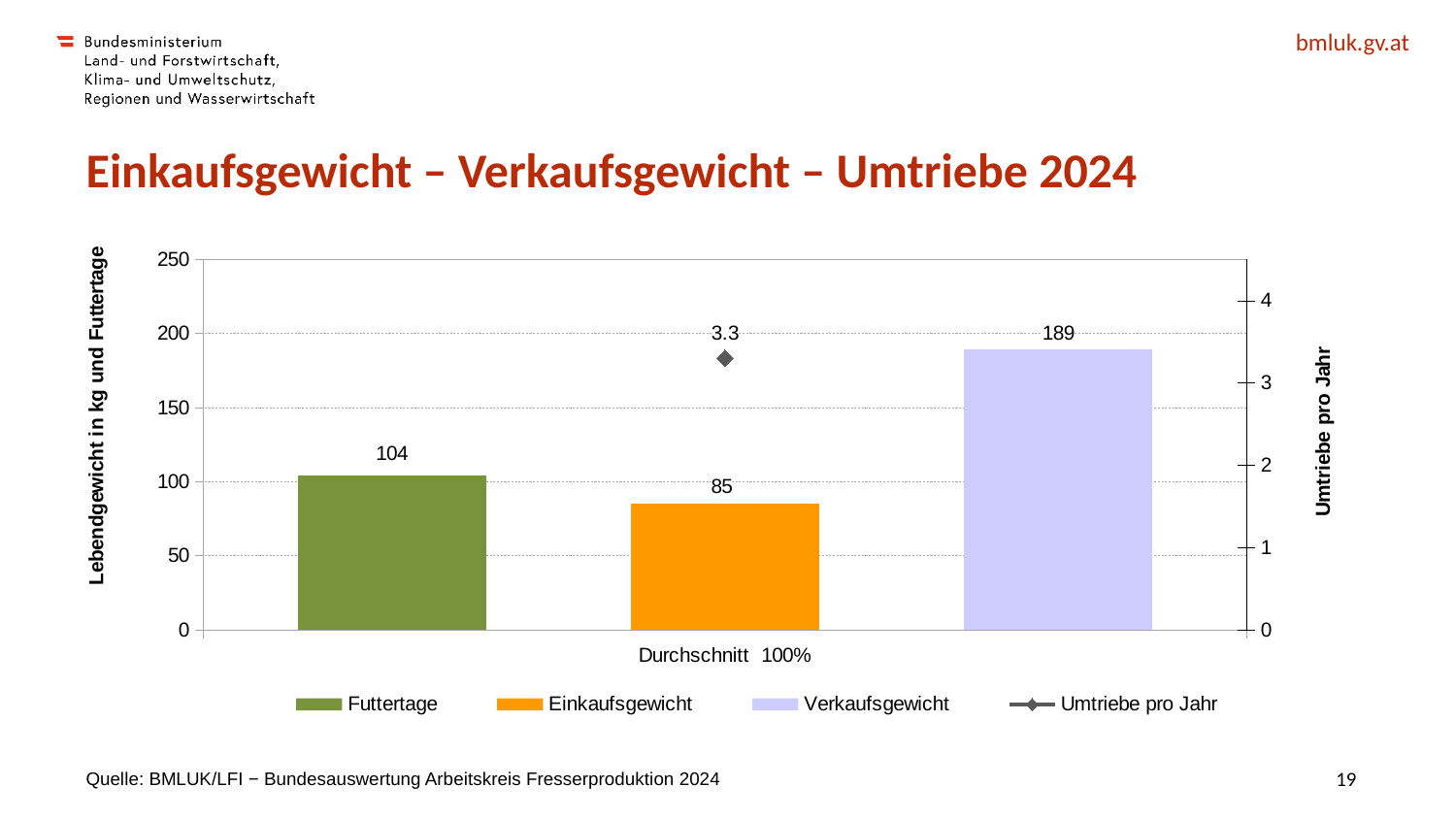
What is the value for Verkaufsgewicht? 189 How many series does the legend list? 4 What is the title of the chart's left vertical axis? Lebendgewicht in kg und Futtertage Which is larger, Futtertage or Einkaufsgewicht? Futtertage What kind of chart is shown on the slide? bar chart Which of the three bars has the lowest value? Einkaufsgewicht What is the difference between Verkaufsgewicht and Einkaufsgewicht? 104 Is the value for Verkaufsgewicht greater or less than 150? greater What is the value for Umtriebe pro Jahr? 3.3 What is the value for Einkaufsgewicht? 85 Which of the three bars has the highest value? Verkaufsgewicht What is the value for Futtertage? 104